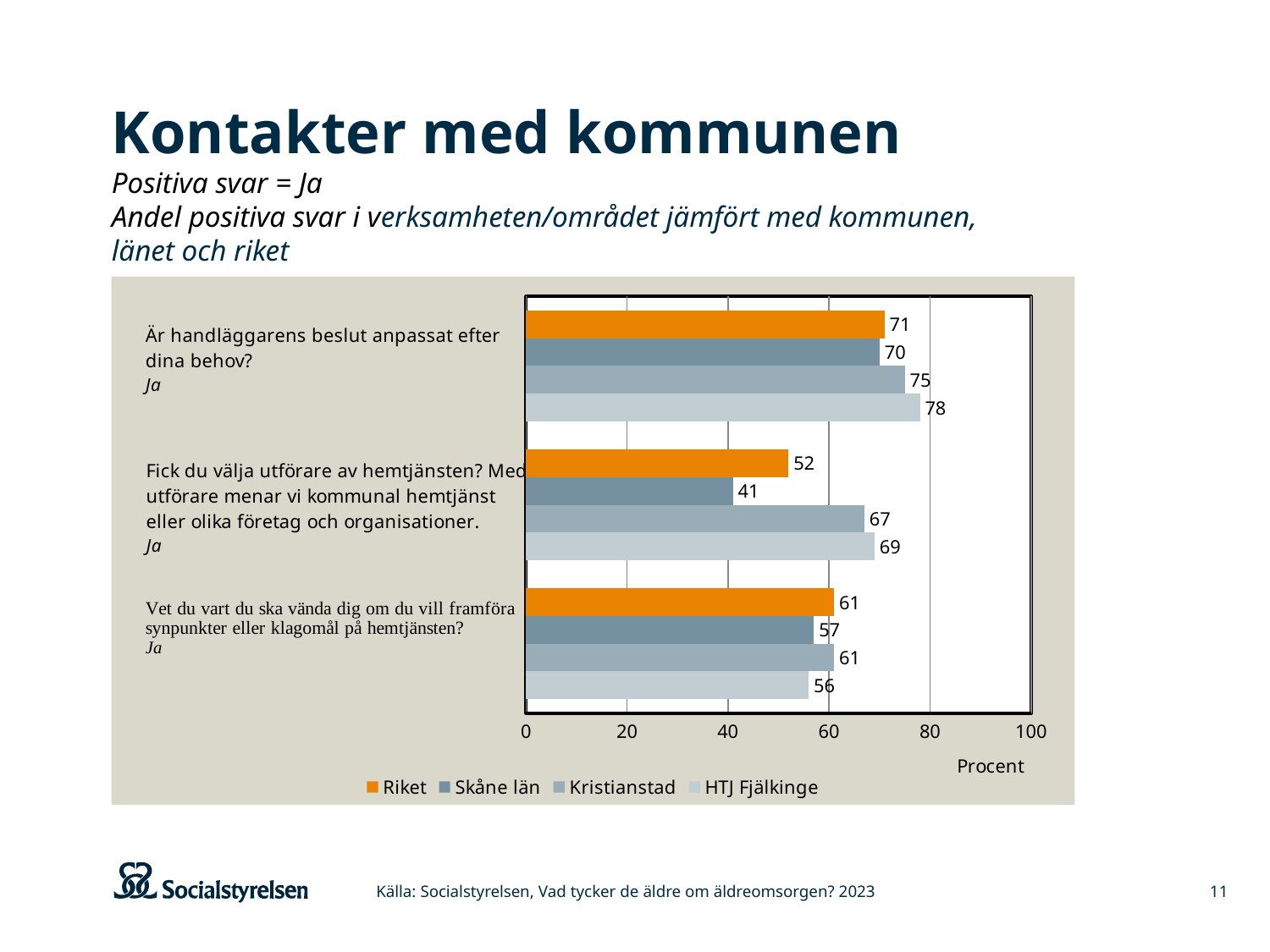
What is the value for HTJ Fjälkinge on the question "Är handläggarens beslut anpassat efter dina behov?"? 78 On the question "Är handläggarens beslut anpassat efter dina behov?", which is larger: the value for Kristianstad or the value for Skåne län? Kristianstad What is the difference between the Kristianstad and Riket values on the question "Fick du välja utförare av hemtjänsten?"? 15 Which series is shown in orange in the legend? Riket How many series does the legend list? 4 What is the value for Skåne län on the question "Fick du välja utförare av hemtjänsten?"? 41 Which series has the highest value on the question "Fick du välja utförare av hemtjänsten?"? HTJ Fjälkinge How many question categories are shown on the chart? 3 What is the value for Riket on the question "Vet du vart du ska vända dig om du vill framföra synpunkter eller klagomål på hemtjänsten?"? 61 Which series has the lowest value on the question "Vet du vart du ska vända dig om du vill framföra synpunkter eller klagomål på hemtjänsten?"? HTJ Fjälkinge What label is shown on the horizontal axis of the chart? Procent What type of chart is shown on the slide? bar chart